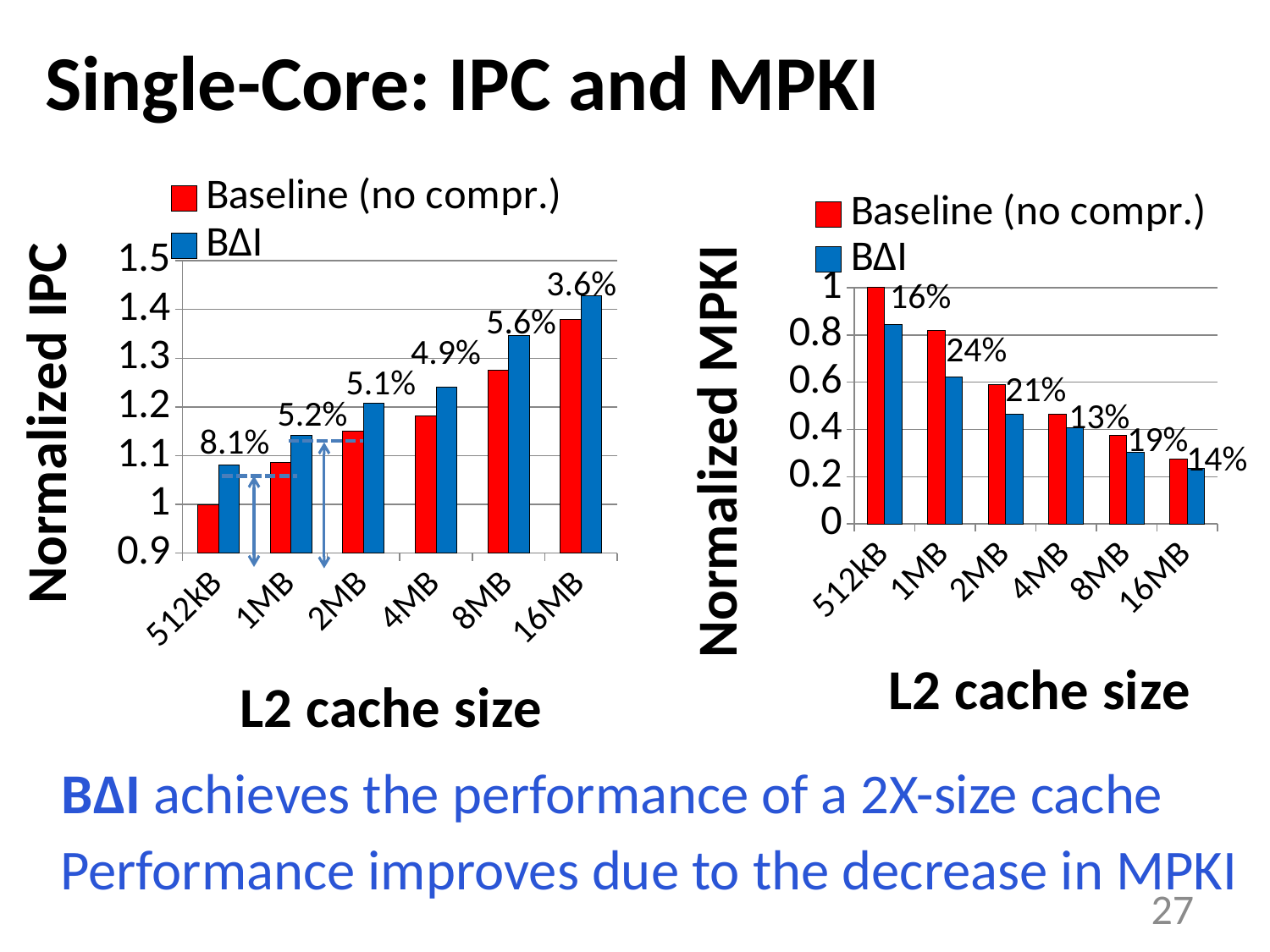
In the Normalized IPC chart on the left, what is the Baseline (no compr.) value at 512kB? 1 In the Normalized IPC chart on the left, is the BΔI value at 4MB greater or less than 1.2? greater In the Normalized IPC chart on the left, what kind of chart is it? bar chart In the Normalized IPC chart on the left, which L2 cache size has the highest BΔI value? 16MB In the Normalized MPKI chart on the right, is the BΔI value at 512kB greater or less than 0.8? greater In the Normalized IPC chart on the left, do the BΔI values rise or fall as the L2 cache size increases? rise In the Normalized MPKI chart on the right, at 1MB, which is larger: Baseline (no compr.) or BΔI? Baseline (no compr.) In the Normalized MPKI chart on the right, do the Baseline (no compr.) values rise or fall as the L2 cache size increases? fall In the Normalized IPC chart on the left, how many L2 cache sizes are shown on the x axis? 6 In the Normalized IPC chart on the left, what percentage label is shown above the 512kB bars? 8.1% In the Normalized MPKI chart on the right, how many series does the legend list? 2 In the Normalized MPKI chart on the right, what is the Baseline (no compr.) value at 512kB? 1